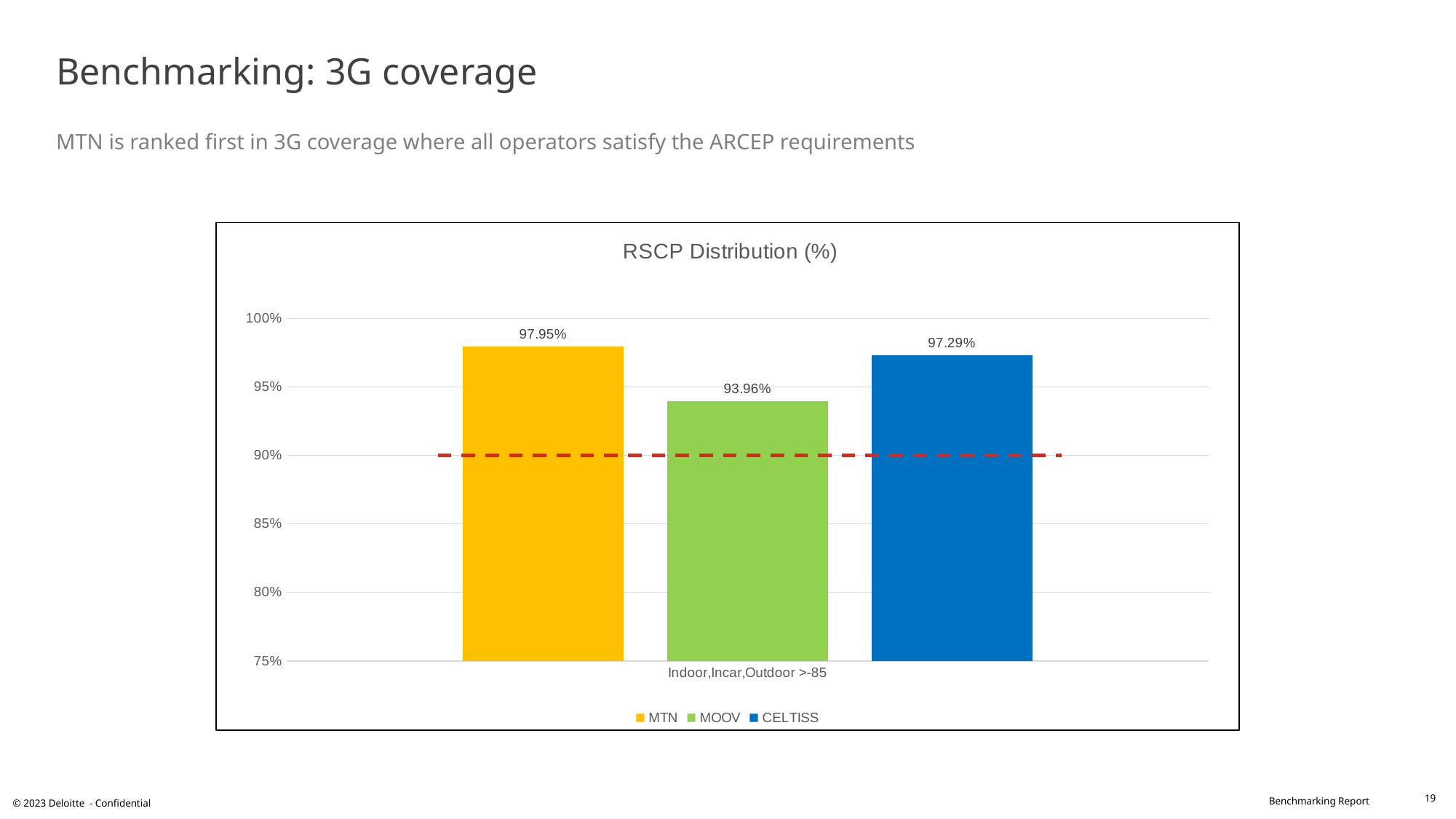
Which operator has the highest RSCP Distribution value? MTN What is the difference between the MTN and MOOV values? 3.99% What is the RSCP Distribution value for MTN? 97.95% Which is larger, the value for MOOV or the value for CELTISS? CELTISS What is the RSCP Distribution value for MOOV? 93.96% Which operator has the lowest RSCP Distribution value? MOOV What is the title of the chart? RSCP Distribution (%) What is the RSCP Distribution value for CELTISS? 97.29% What kind of chart is shown on the slide? Bar chart What is the difference between the CELTISS and MOOV values? 3.33% Is the value for MOOV greater or less than 95%? less How many series does the legend list? 3